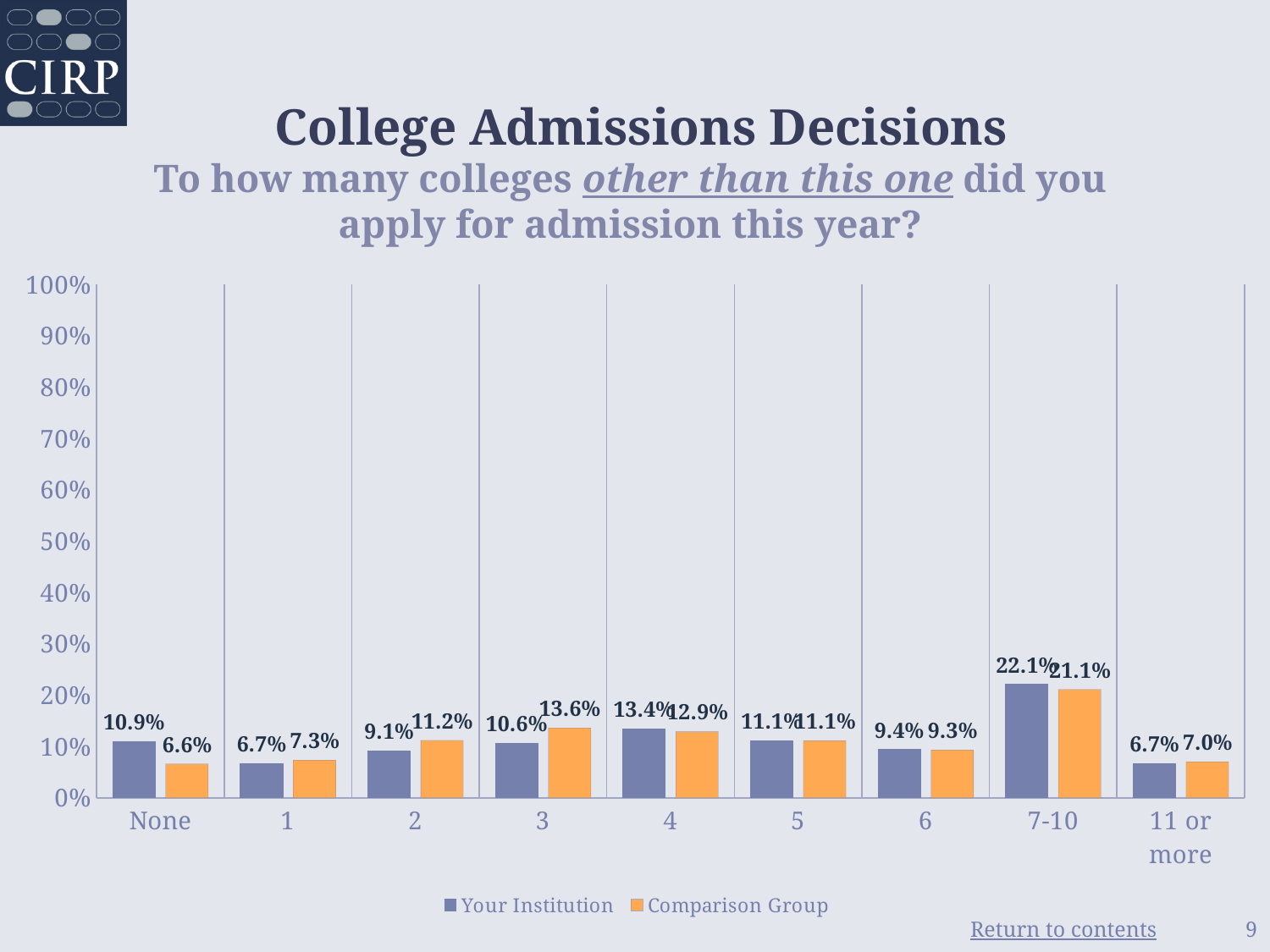
What kind of chart is shown on the slide? Bar chart Which category has the lowest value for the Comparison Group? None In the 2 category, which is larger: Your Institution or the Comparison Group? Comparison Group Which category has the highest value for the Comparison Group? 7-10 What is the value for Your Institution in the None category? 10.9% What is the value for the Comparison Group in the 11 or more category? 7.0% How many categories are shown on the x axis? 9 What is the value for the Comparison Group in the 3 category? 13.6% How many series does the legend list? 2 What is the value for Your Institution in the 7-10 category? 22.1% Is the value for Your Institution in the 7-10 category greater or less than 20%? greater What is the difference between Your Institution and the Comparison Group in the None category? 4.3%